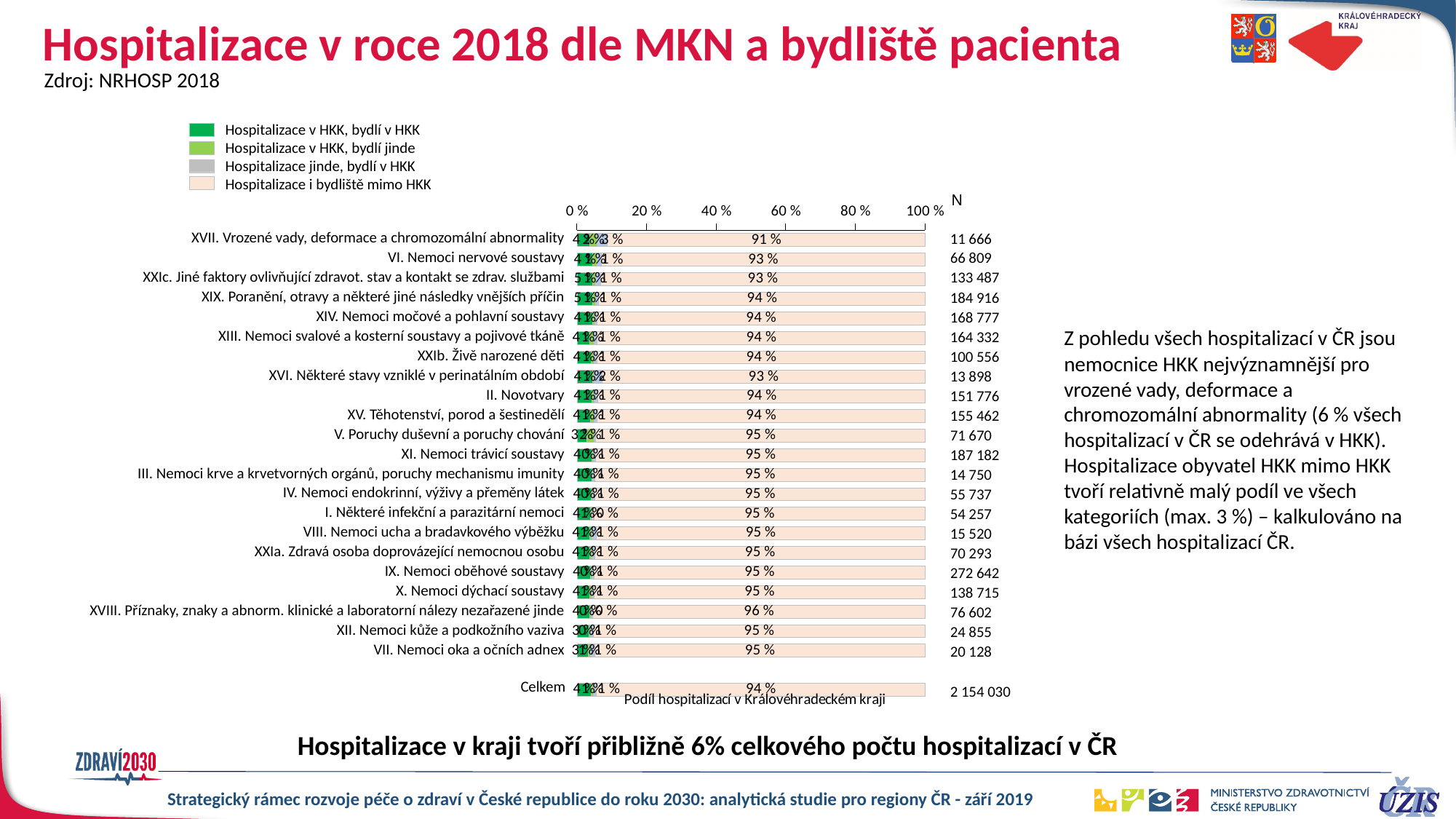
Which category has the lowest 'Hospitalizace i bydliště mimo HKK' share? XVII. Vrozené vady, deformace a chromozomální abnormality What is the N value shown for the 'Celkem' row? 2 154 030 What is the 'Hospitalizace i bydliště mimo HKK' share for 'XVIII. Příznaky, znaky a abnorm. klinické a laboratorní nálezy nezařazené jinde'? 96 % What is the N value shown for 'IX. Nemoci oběhové soustavy'? 272 642 Which has the larger 'Hospitalizace i bydliště mimo HKK' share: 'VI. Nemoci nervové soustavy' or 'XVII. Vrozené vady, deformace a chromozomální abnormality'? VI. Nemoci nervové soustavy What is the difference between the 'Hospitalizace i bydliště mimo HKK' share for 'XVIII. Příznaky, znaky a abnorm. klinické a laboratorní nálezy nezařazené jinde' and for 'XVII. Vrozené vady, deformace a chromozomální abnormality'? 5 % How many MKN chapter categories are plotted, not counting the 'Celkem' row? 22 What is the 'Hospitalizace i bydliště mimo HKK' share for the 'Celkem' row? 94 % How many series does the legend list? 4 What is the 'Hospitalizace i bydliště mimo HKK' share for 'XVII. Vrozené vady, deformace a chromozomální abnormality'? 91 % What is the title of the x axis of the chart? Podíl hospitalizací v Královéhradeckém kraji What kind of chart is shown on the slide? Stacked horizontal bar chart